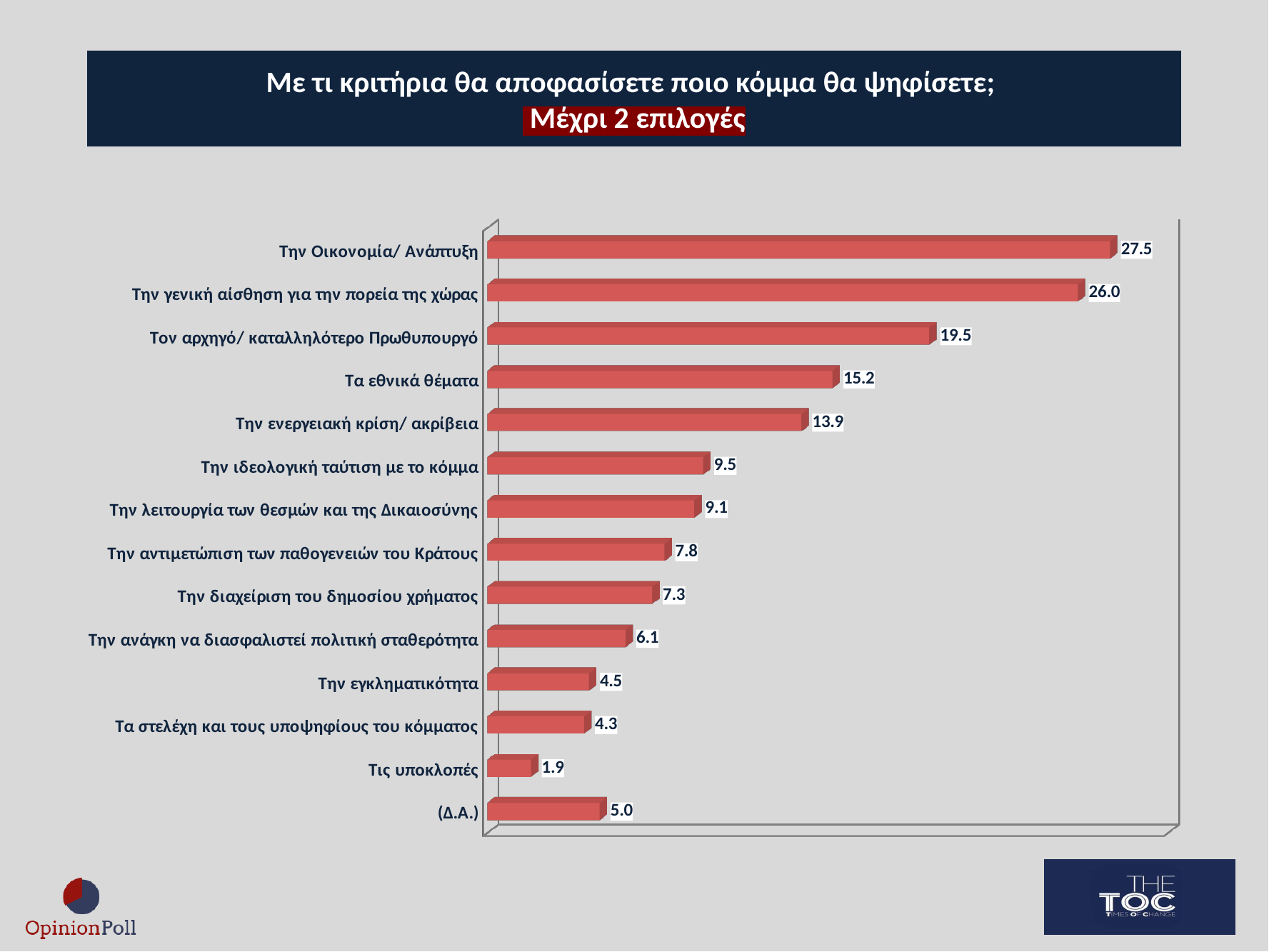
What is the difference between the values for Τον αρχηγό/ καταλληλότερο Πρωθυπουργό and Την ενεργειακή κρίση/ ακρίβεια? 5.6 What kind of chart is shown on the slide? Bar chart How many categories are shown in the chart? 14 What is the difference between the values for Την Οικονομία/ Ανάπτυξη and Την γενική αίσθηση για την πορεία της χώρας? 1.5 What is the subtitle shown in the red box under the chart title? Μέχρι 2 επιλογές What is the value for Την εγκληματικότητα? 4.5 What is the value for Την Οικονομία/ Ανάπτυξη? 27.5 What is the value for (Δ.Α.)? 5.0 Which category has the lowest value? Τις υποκλοπές What is the value for Τα εθνικά θέματα? 15.2 Which is larger, the value for Την ιδεολογική ταύτιση με το κόμμα or the value for Την διαχείριση του δημοσίου χρήματος? Την ιδεολογική ταύτιση με το κόμμα Which category has the highest value? Την Οικονομία/ Ανάπτυξη